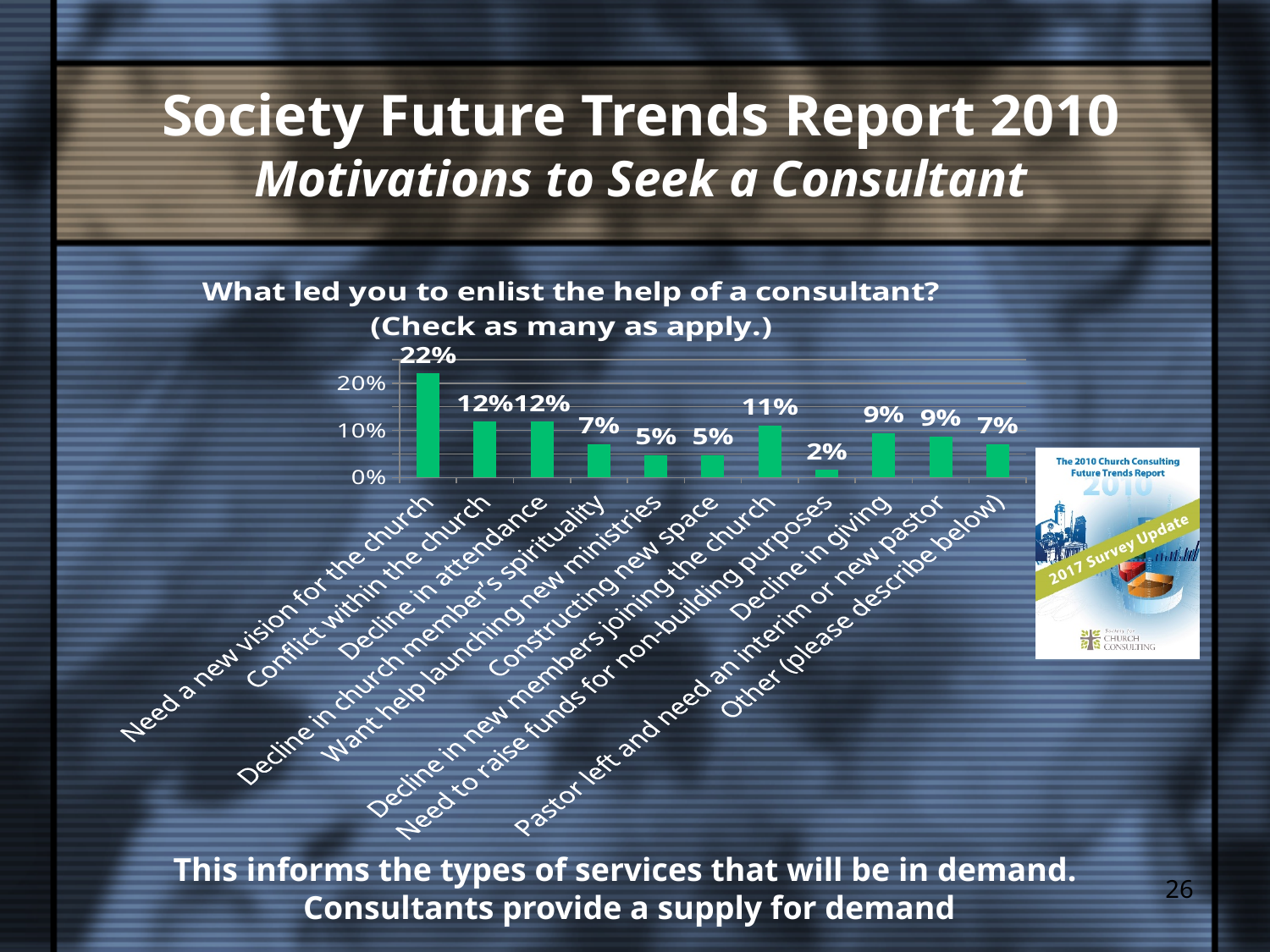
What is the value for "Decline in giving"? 9% Is the value for "Decline in new members joining the church" greater or less than 10%? greater What percentage of respondents selected "Need a new vision for the church"? 22% Which is larger, "Decline in attendance" or "Decline in church member's spirituality"? Decline in attendance What is the value for "Decline in new members joining the church"? 11% What is the value for "Need to raise funds for non-building purposes"? 2% What kind of chart is shown on the slide? bar chart What is the title of the chart? What led you to enlist the help of a consultant? (Check as many as apply.) How many categories are shown in the chart? 11 What is the difference between "Need a new vision for the church" and "Conflict within the church"? 10% Which category has the highest value? Need a new vision for the church Which category has the lowest value? Need to raise funds for non-building purposes